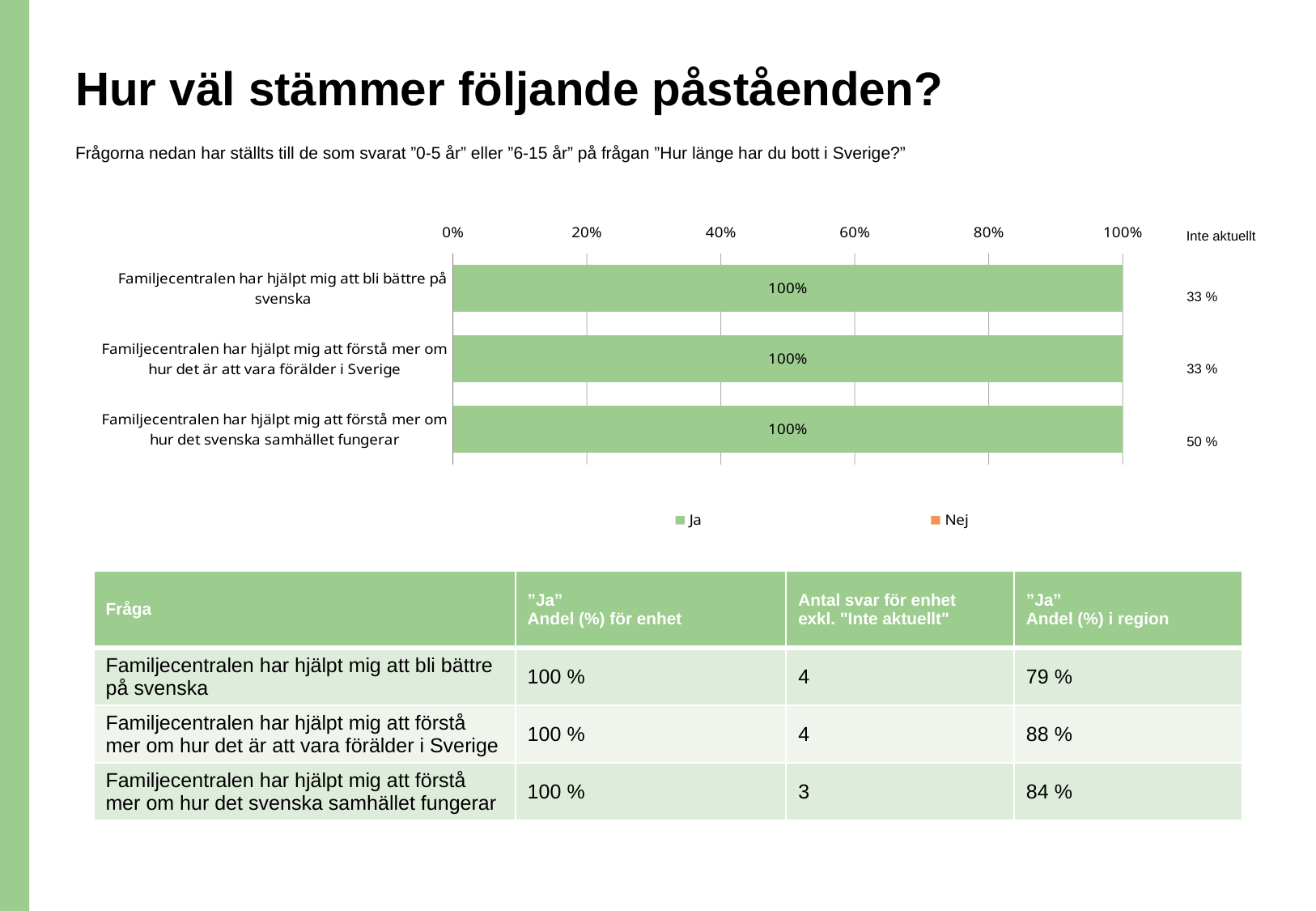
What is the difference between the "Ja" values for "bli bättre på svenska" and "förstå mer om hur det svenska samhället fungerar"? 0% Is the "Ja" value for "Familjecentralen har hjälpt mig att bli bättre på svenska" greater or less than 80%? greater What is the "Ja" value for "Familjecentralen har hjälpt mig att bli bättre på svenska"? 100% How many series does the chart legend list? 2 How many categories (statements) does the bar chart show? 3 What are the two series named in the chart legend? Ja and Nej What kind of chart is shown on the slide? Bar chart What is the "Ja" value for "Familjecentralen har hjälpt mig att förstå mer om hur det svenska samhället fungerar"? 100% What colour represents the "Ja" series in the chart? Green What is the highest value shown on the chart's percentage axis? 100% What is the "Ja" value for "Familjecentralen har hjälpt mig att förstå mer om hur det är att vara förälder i Sverige"? 100%